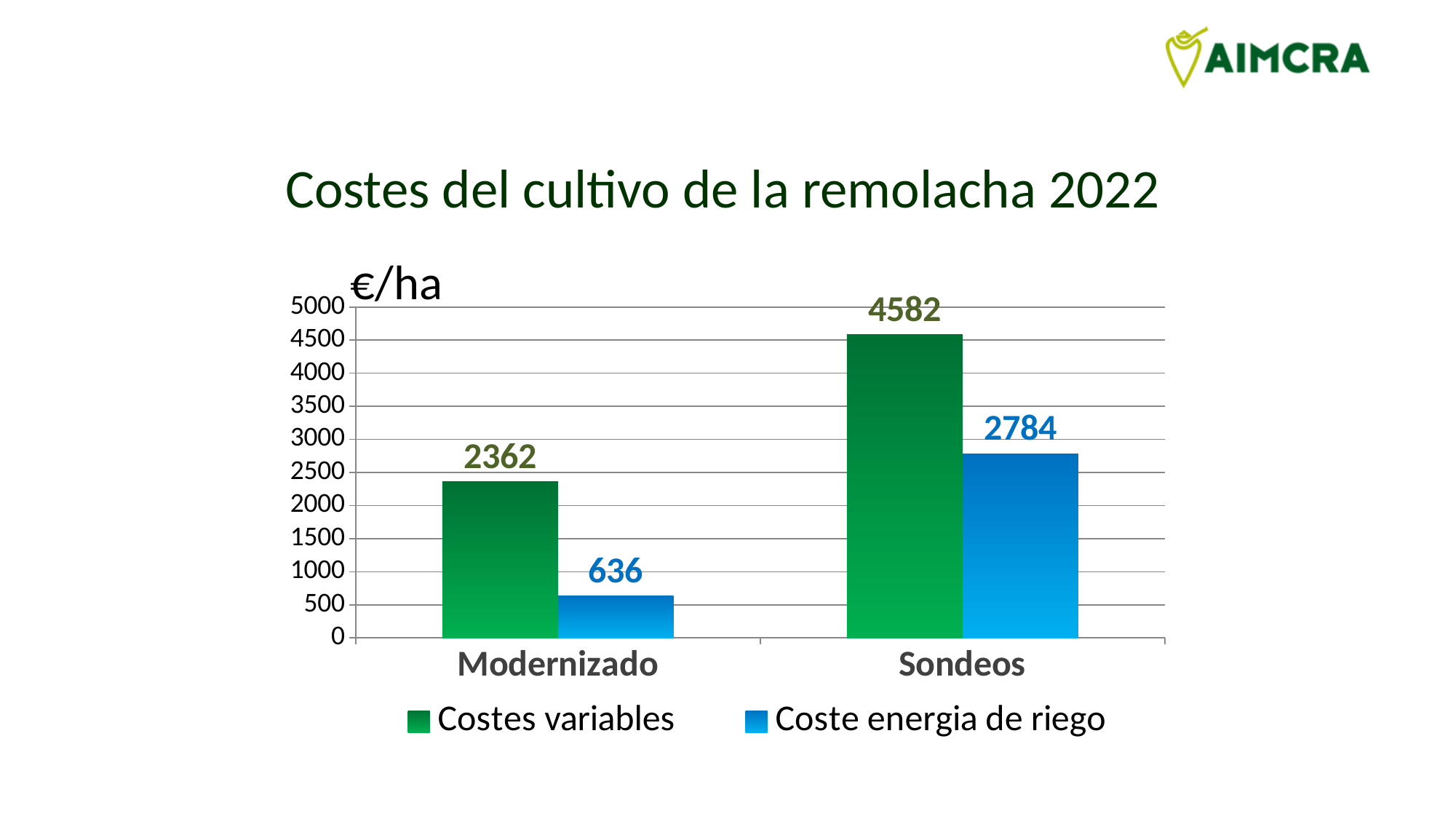
Which is larger: Costes variables for Modernizado or Coste energia de riego for Sondeos? Coste energia de riego for Sondeos Is the value of Costes variables for Sondeos greater or less than 4000? greater Which category has the highest Costes variables value? Sondeos Which category has the lowest Coste energia de riego value? Modernizado How many categories are shown on the x axis? 2 What type of chart is shown on the slide? Bar chart What is the value of Coste energia de riego for Sondeos? 2784 What is the difference between Coste energia de riego for Sondeos and for Modernizado? 2148 What is the value of Coste energia de riego for Modernizado? 636 What is the value of Costes variables for Modernizado? 2362 What is the difference between Costes variables for Sondeos and for Modernizado? 2220 How many series does the legend list? 2